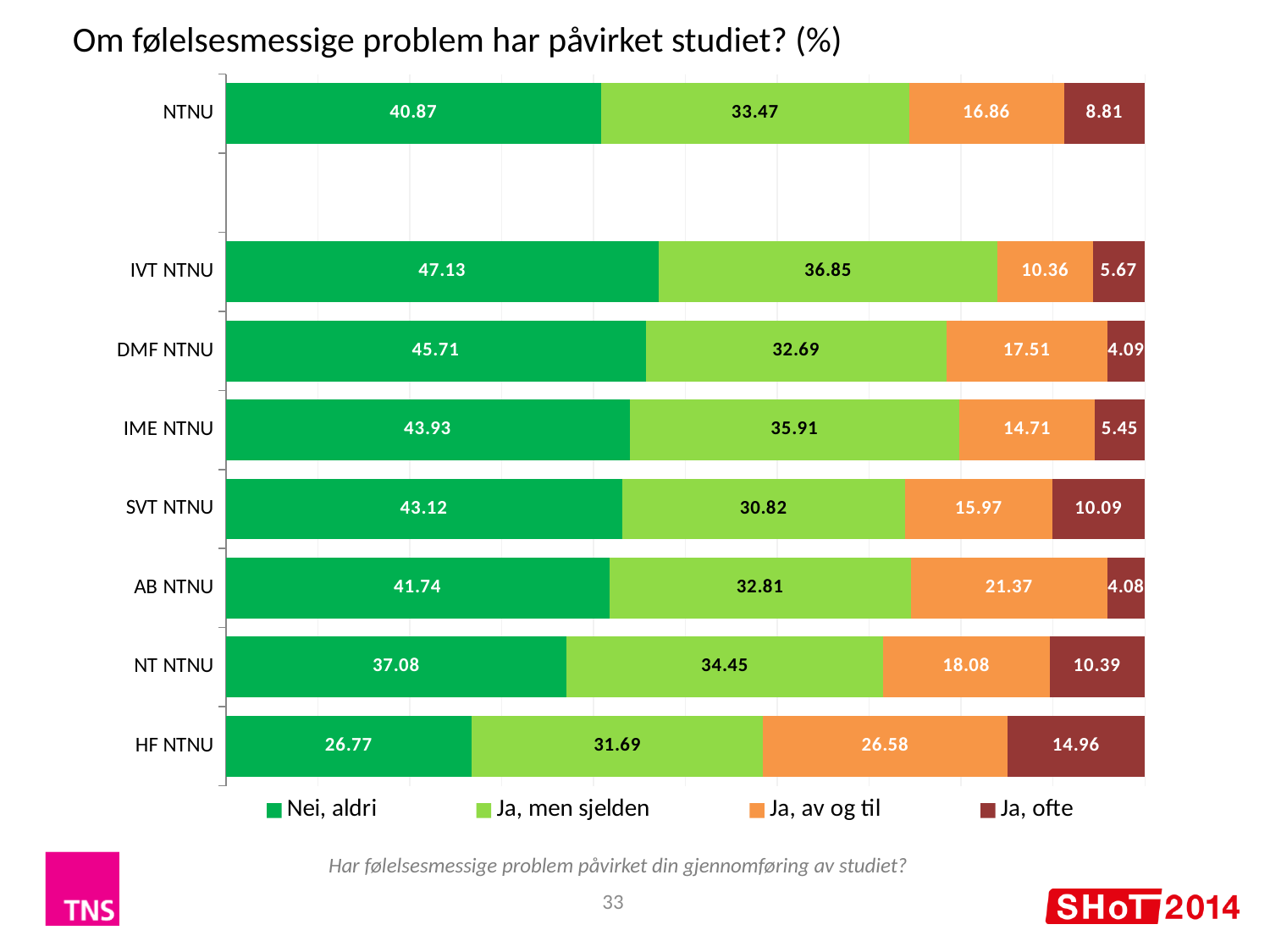
Which category has the highest value for 'Ja, ofte'? HF NTNU What kind of chart is shown on the slide? Stacked bar chart How many series does the legend list? 4 Which category has the lowest value for 'Nei, aldri'? HF NTNU How many categories are shown on the chart? 8 What is the difference between the 'Nei, aldri' and 'Ja, men sjelden' values for NTNU? 7.40 What is the value for 'Ja, ofte' for SVT NTNU? 10.09 What is the value for 'Nei, aldri' for HF NTNU? 26.77 Which category has the highest value for 'Nei, aldri'? IVT NTNU What is the title of the chart? Om følelsesmessige problem har påvirket studiet? (%) Is the 'Ja, av og til' value larger for HF NTNU or for NTNU? HF NTNU What is the value for 'Ja, av og til' for AB NTNU? 21.37